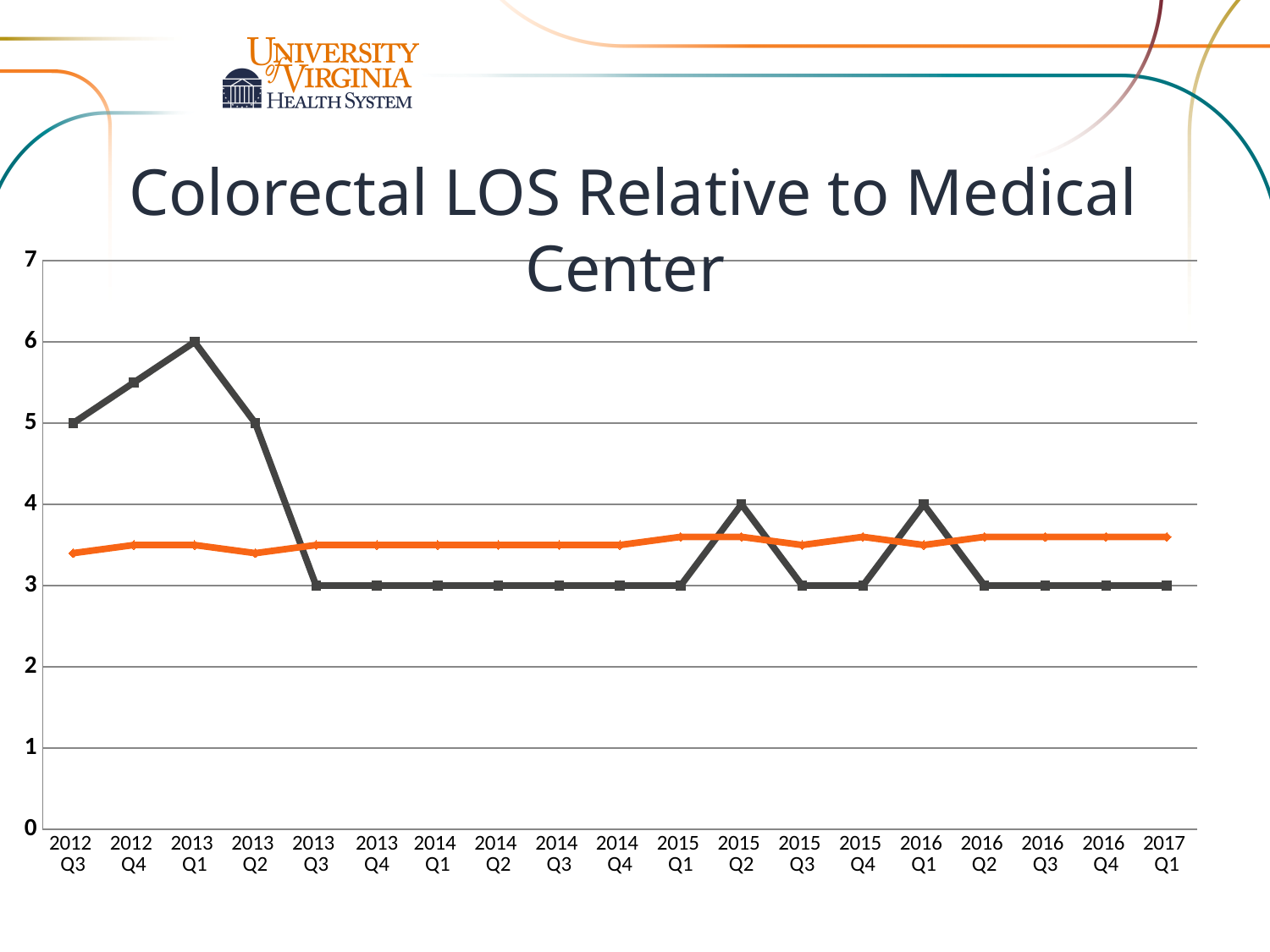
In which quarter does the dark gray line reach its highest value? 2013 Q1 What is the value of the dark gray line at 2013 Q1? 6 What is the difference between the dark gray line's value at 2013 Q1 and its value at 2013 Q3? 3 What is the value of the dark gray line at 2015 Q2? 4 At 2013 Q1, which line is higher, the dark gray line or the orange line? dark gray line How many quarters are labelled along the x axis of the chart? 19 Is the value of the orange line at 2014 Q1 greater or less than 4? less What kind of chart is shown on the slide? line chart What is the value of the dark gray line at 2012 Q3? 5 How many lines are plotted on the chart? 2 At 2014 Q2, which line is higher, the dark gray line or the orange line? orange line What is the title of the chart? Colorectal LOS Relative to Medical Center